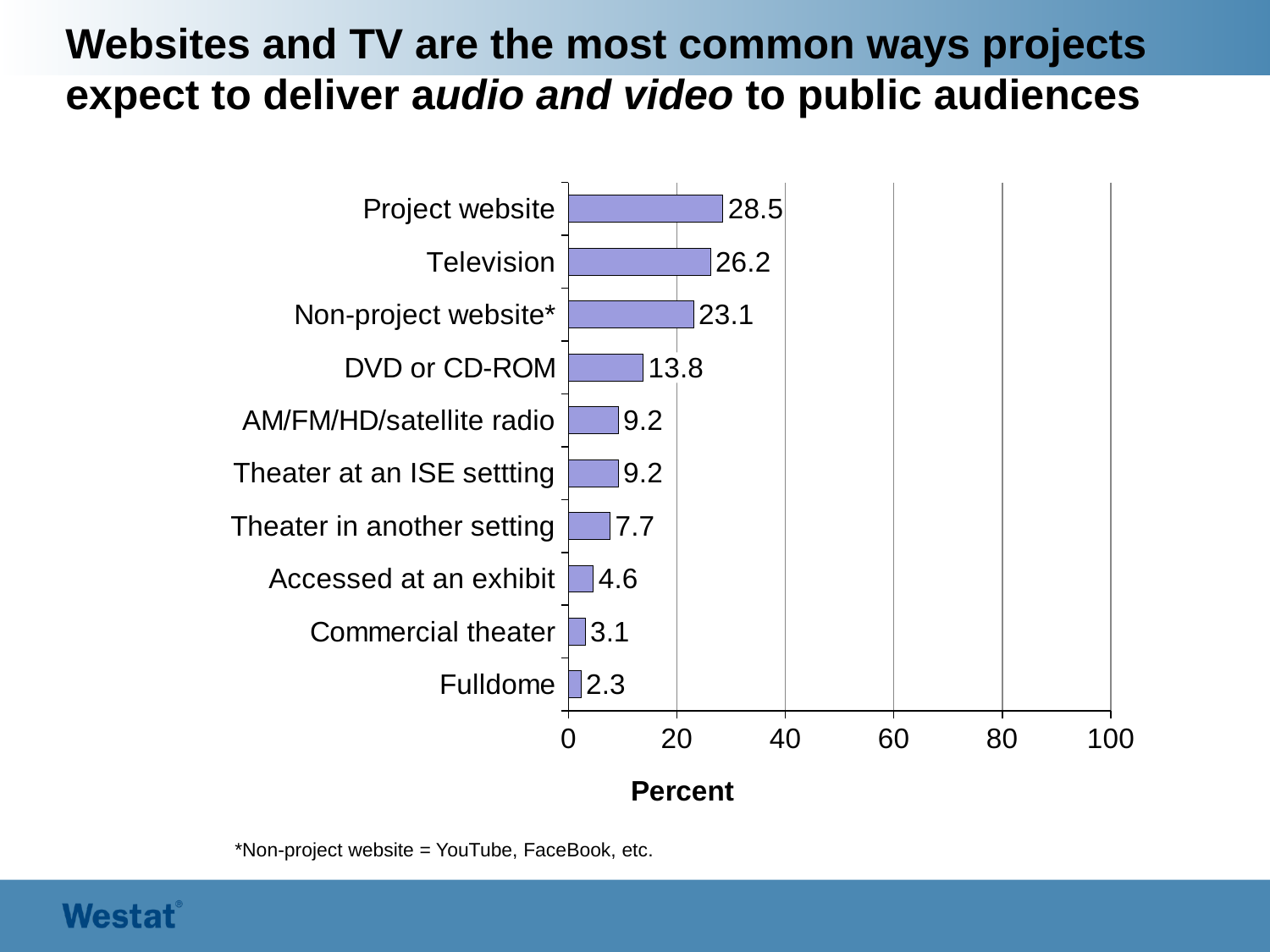
How many categories are shown in the chart? 10 What is the difference between the values for Project website and Television? 2.3 Which is larger, the value for Television or the value for Non-project website*? Television What is the value for Project website? 28.5 What is the difference between the values for Non-project website* and DVD or CD-ROM? 9.3 What is the value for Fulldome? 2.3 What is the value for DVD or CD-ROM? 13.8 What is the label on the horizontal axis of the chart? Percent Which category has the highest value? Project website Which category has the lowest value? Fulldome What kind of chart is shown on the slide? bar chart Is the value for Project website greater or less than 40? less